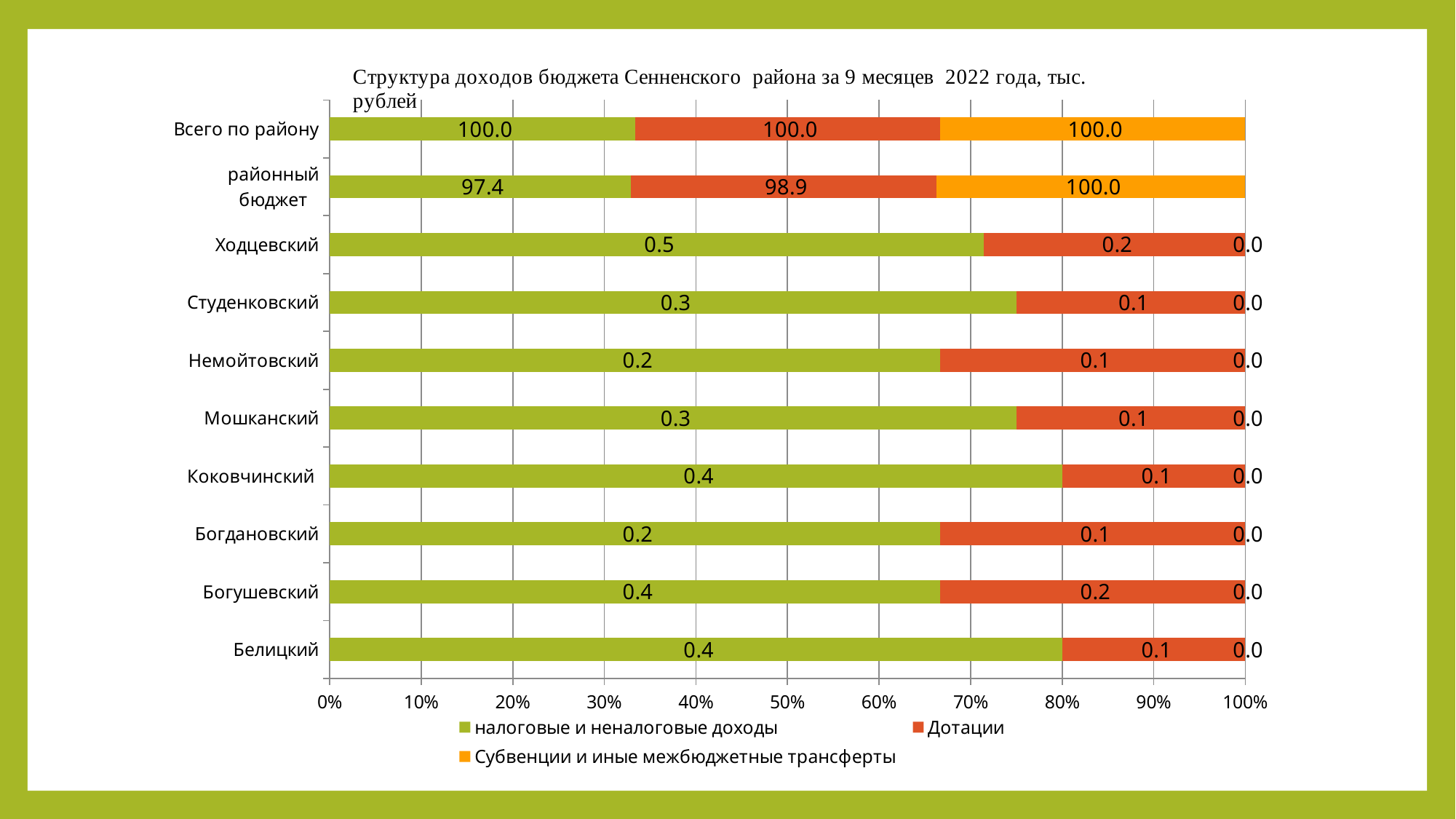
What is the value of 'налоговые и неналоговые доходы' for 'районный бюджет'? 97.4 What is the value of 'Дотации' for 'Богушевский'? 0.2 What is the value of 'Дотации' for 'районный бюджет'? 98.9 What is the value of 'Субвенции и иные межбюджетные трансферты' for 'Белицкий'? 0.0 How many categories are shown on the vertical axis of the chart? 10 Among the rural councils (excluding 'Всего по району' and 'районный бюджет'), which category has the highest labelled value for 'налоговые и неналоговые доходы'? Ходцевский What is the difference between the 'Дотации' value for 'Всего по району' and for 'районный бюджет'? 1.1 What is the value of 'налоговые и неналоговые доходы' for 'Ходцевский'? 0.5 What type of chart is shown on the slide? stacked bar chart How many series does the legend list? 3 Which is larger: the 'налоговые и неналоговые доходы' value for 'Коковчинский' or for 'Немойтовский'? Коковчинский Which series is shown in orange in the legend? Субвенции и иные межбюджетные трансферты